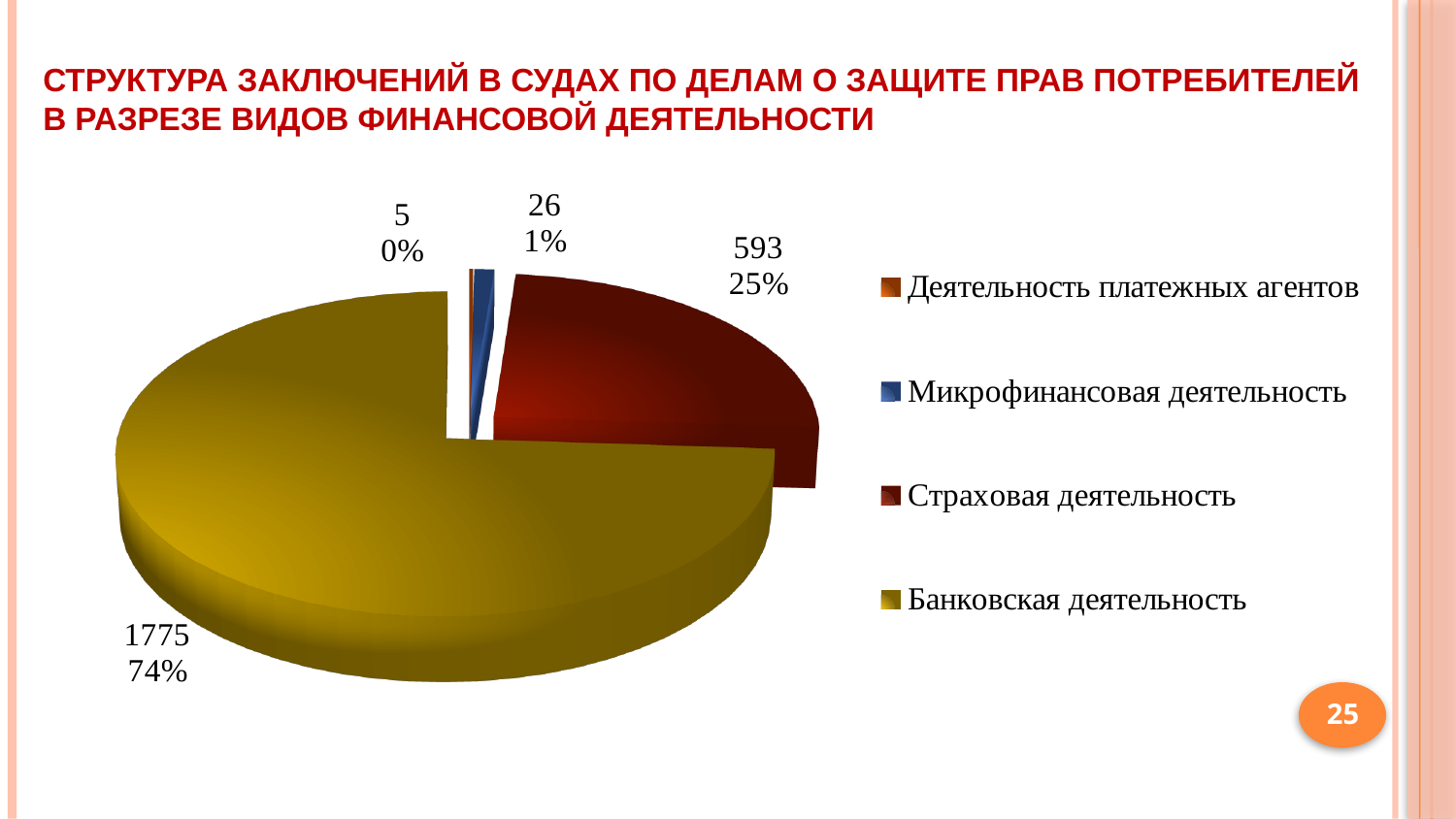
What is the value for Деятельность платежных агентов? 5 Which colour represents Микрофинансовая деятельность in the pie chart? blue What share of the pie does Страховая деятельность represent? 25% What is the value for Банковская деятельность? 1775 What is the value for Страховая деятельность? 593 What is the difference between the values for Банковская деятельность and Страховая деятельность? 1182 Which category has the largest slice of the pie? Банковская деятельность What is the value for Микрофинансовая деятельность? 26 What kind of chart is shown on the slide? pie chart Which category has the smallest slice of the pie? Деятельность платежных агентов How many entries does the legend list? 4 How many slices does the pie chart have? 4